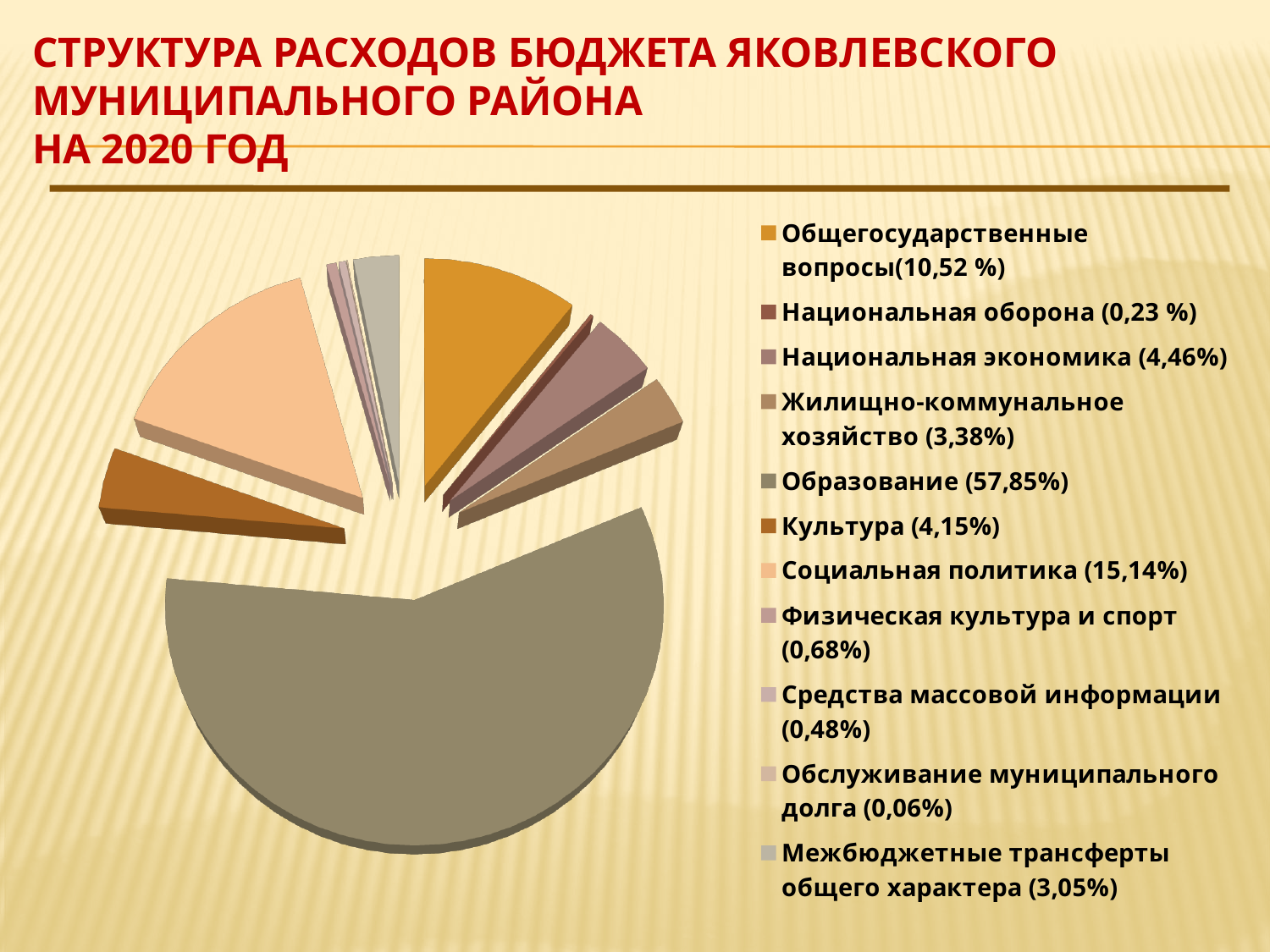
What is the value shown for Общегосударственные вопросы? 10,52 % Which category has the largest share of the pie? Образование What kind of chart is shown on the slide? pie chart What is the value shown for Межбюджетные трансферты общего характера? 3,05% Which is larger: the share of Социальная политика or the share of Общегосударственные вопросы? Социальная политика What share of the budget expenditure goes to Образование? 57,85% What is the value shown for Обслуживание муниципального долга? 0,06% What year does the chart title say the budget expenditure structure is for? 2020 Which category has the smallest share of the pie? Обслуживание муниципального долга What is the difference between the shares of Образование and Социальная политика? 42,71% What is the value shown for Социальная политика? 15,14% How many categories does the pie chart have? 11